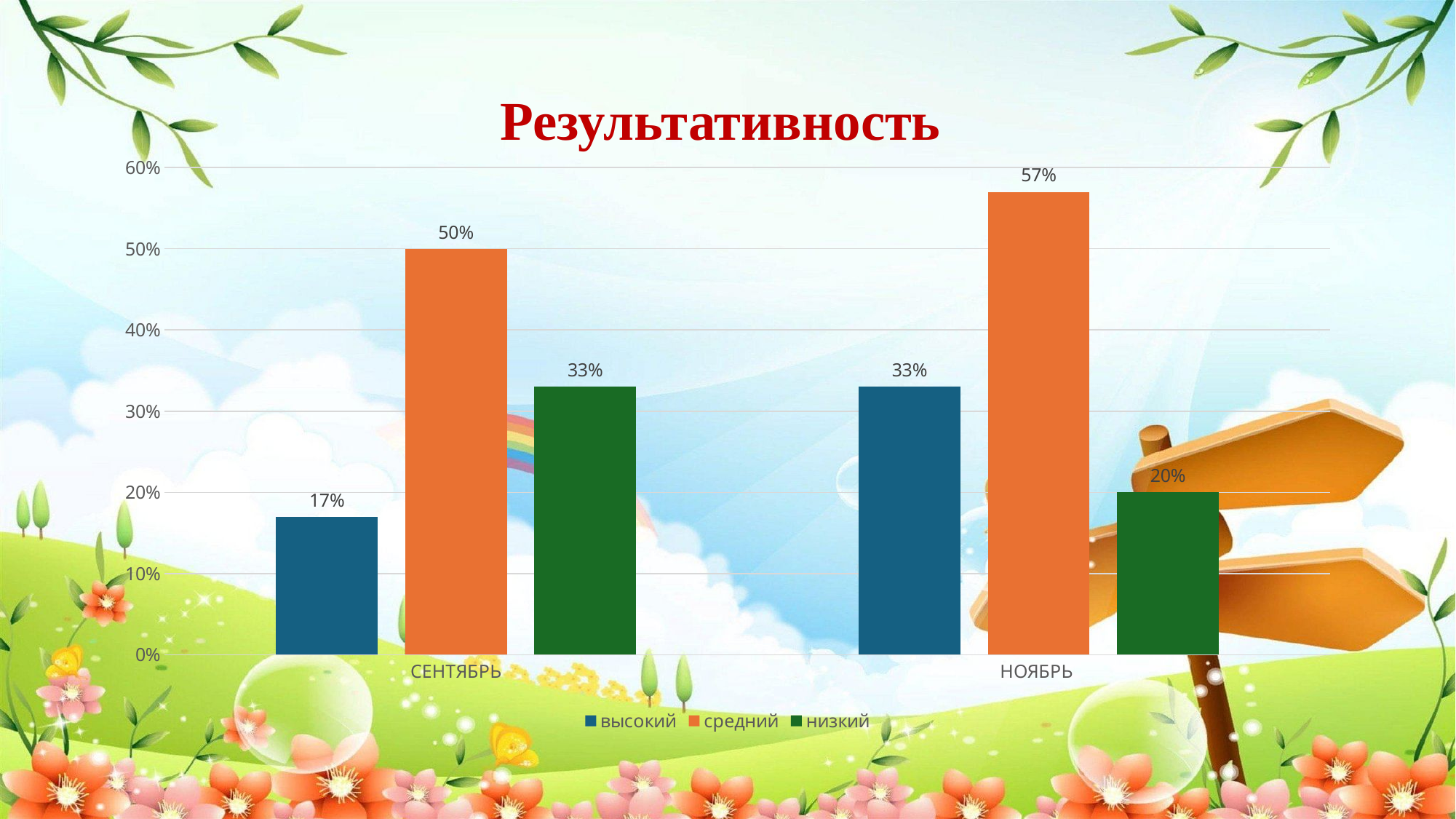
What is the difference between the средний values in НОЯБРЬ and СЕНТЯБРЬ? 7% Which series has the lowest value in СЕНТЯБРЬ? высокий What is the title of the chart? Результативность What is the value for низкий in НОЯБРЬ? 20% How many series does the legend list? 3 What is the value for высокий in СЕНТЯБРЬ? 17% What is the value for средний in НОЯБРЬ? 57% How many categories are shown on the x axis? 2 What kind of chart is shown on the slide? bar chart What is the value for средний in СЕНТЯБРЬ? 50% Which is larger: низкий in СЕНТЯБРЬ or низкий in НОЯБРЬ? низкий in СЕНТЯБРЬ Which series has the highest value in НОЯБРЬ? средний